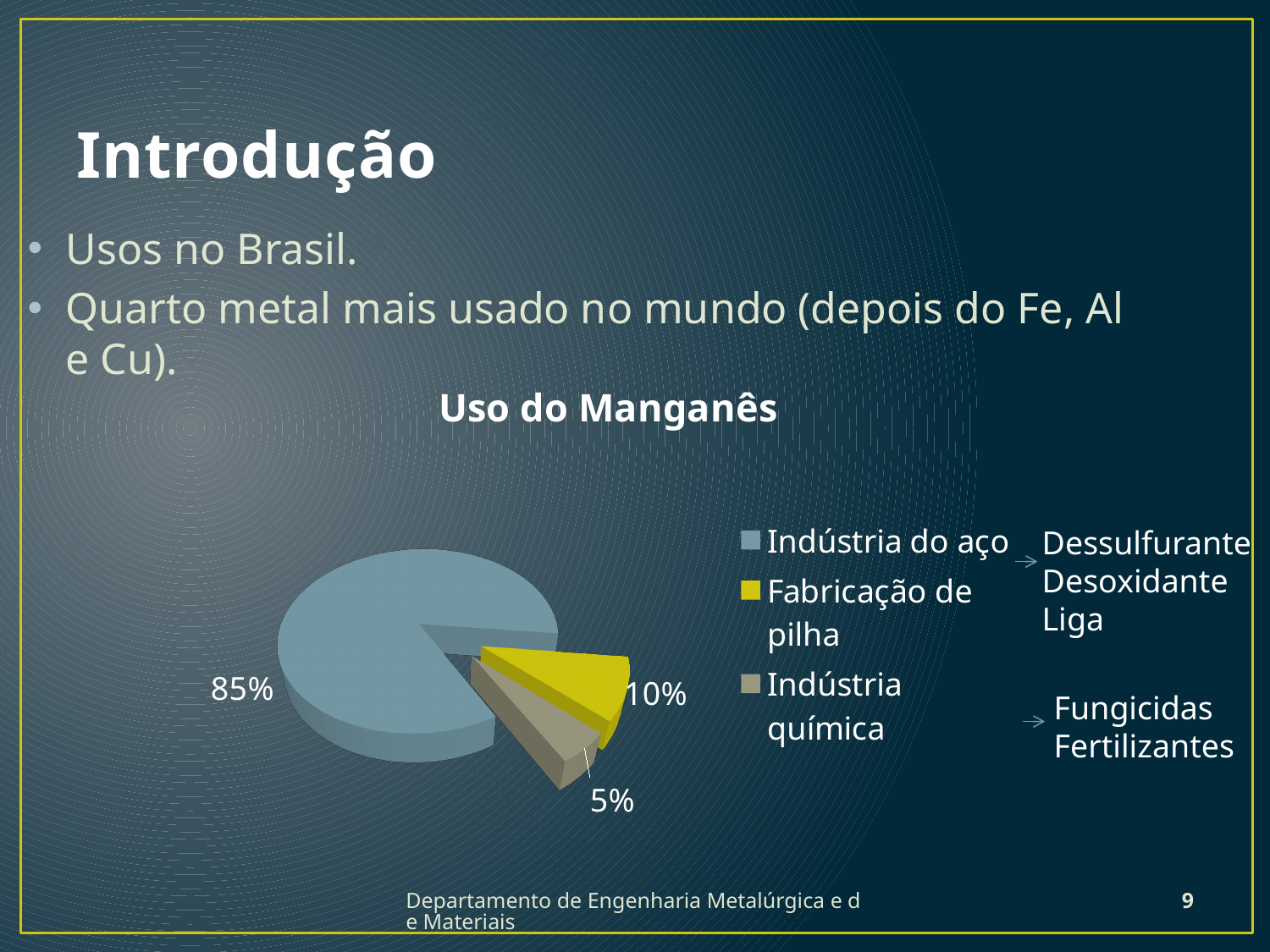
Which category has the smallest slice of the pie? Indústria química What is the difference between the shares of Fabricação de pilha and Indústria química? 5% What kind of chart is shown on the slide? Pie chart What is the title of the chart? Uso do Manganês Which category has the largest slice of the pie? Indústria do aço How many categories does the pie chart show? 3 Which is larger, the share for Fabricação de pilha or the share for Indústria química? Fabricação de pilha What colour is the slice for Fabricação de pilha? Yellow What share of the pie does Fabricação de pilha represent? 10% What is the difference between the shares of Indústria do aço and Fabricação de pilha? 75% What share of the pie does Indústria do aço represent? 85% What share of the pie does Indústria química represent? 5%